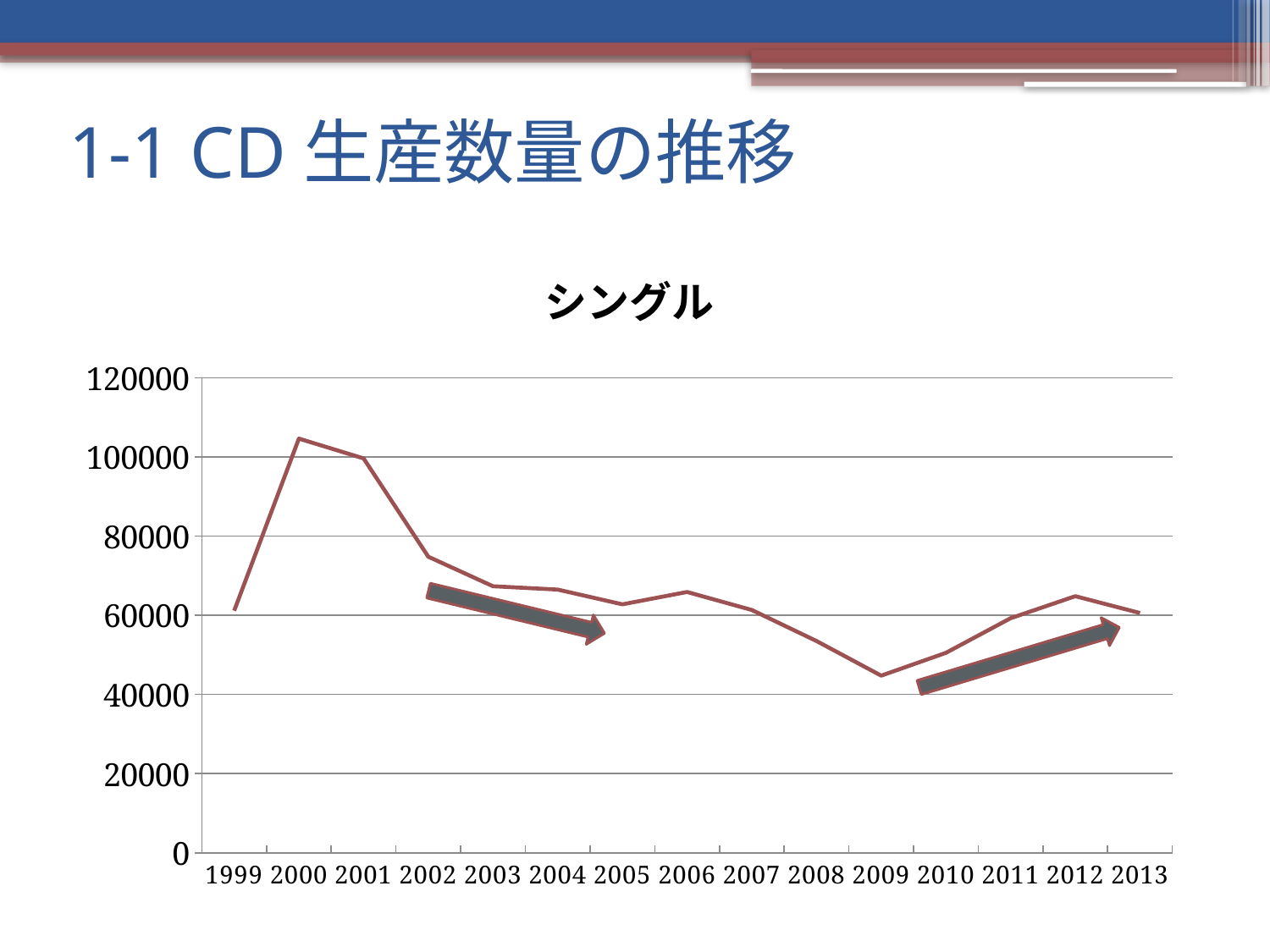
Is the value for 2008 greater or less than 40000? greater Do the values rise or fall from 2009 to 2012? rise How many years are plotted on the x axis of the chart? 15 Which year has the lowest value in the chart? 2009 Is the value for 2002 greater or less than 80000? less Is the value for 2009 greater or less than 50000? less What is the title of the chart? シングル Which year has the larger value, 2009 or 2012? 2012 What kind of chart is shown on the slide? line chart Which year has the larger value, 2002 or 2012? 2002 Which year has the highest value in the chart? 2000